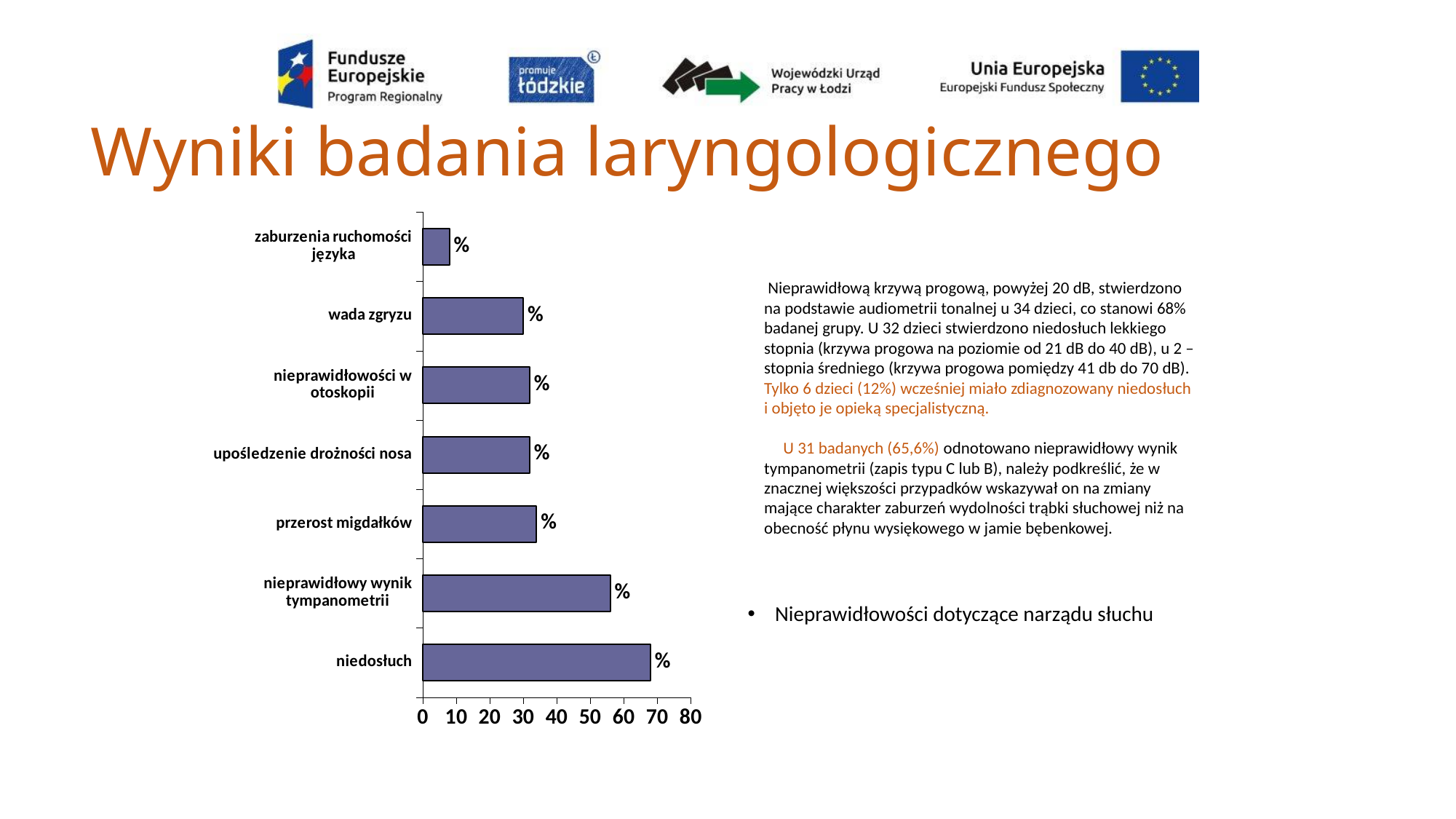
Is the value for przerost migdałków greater or less than 40? less Is the value for nieprawidłowy wynik tympanometrii greater or less than 50? greater What is the highest value shown on the horizontal axis of the chart? 80 Is the value for zaburzenia ruchomości języka greater or less than 10? less What kind of chart is shown on the slide? bar chart Which is larger, the value for nieprawidłowy wynik tympanometrii or the value for przerost migdałków? nieprawidłowy wynik tympanometrii Which is larger, the value for niedosłuch or the value for nieprawidłowy wynik tympanometrii? niedosłuch Which category has the lowest value? zaburzenia ruchomości języka How many categories does the chart show? 7 Which category has the highest value? niedosłuch